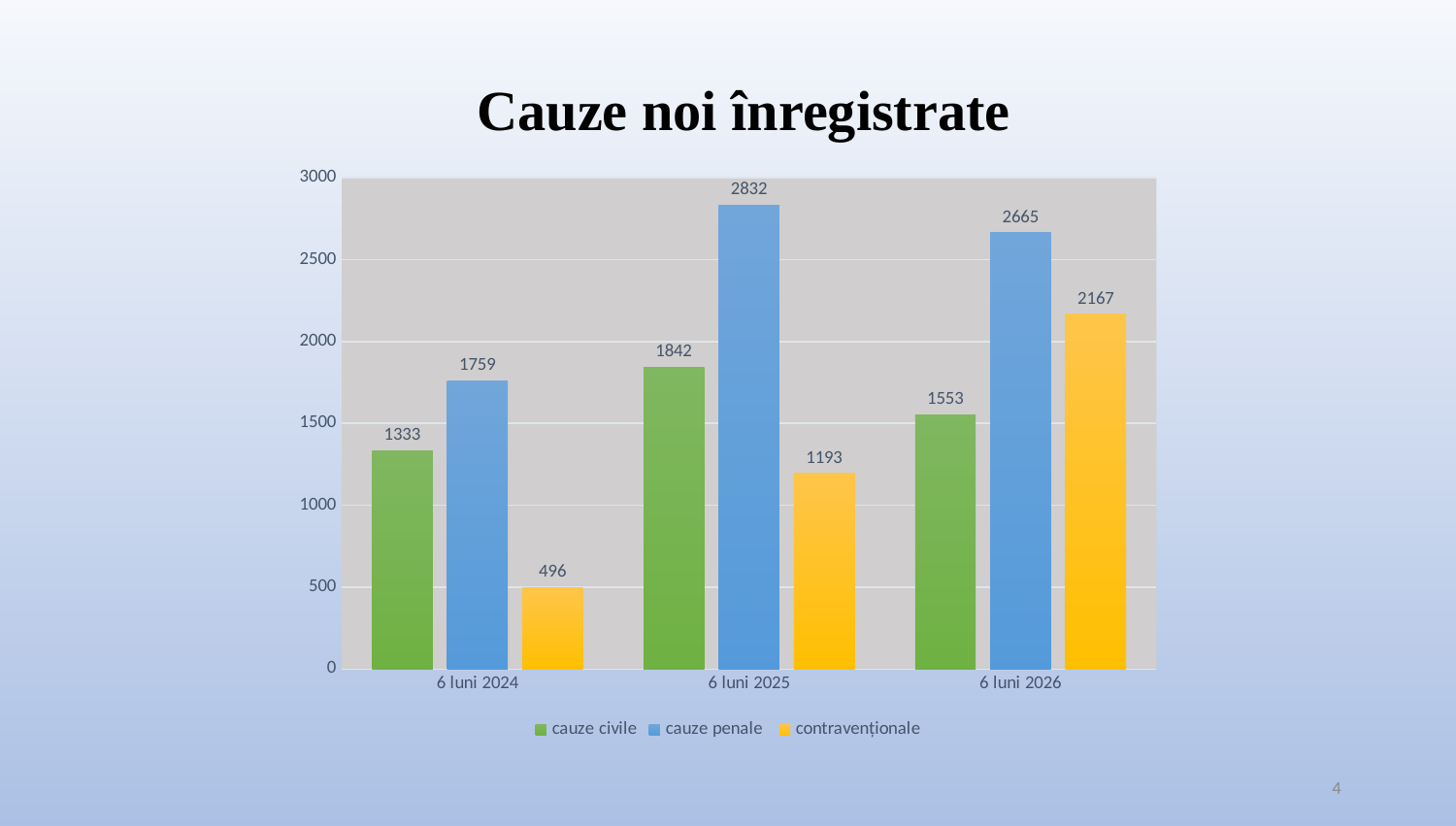
Which period has the highest value for cauze civile? 6 luni 2025 How many series does the legend list? 3 What is the difference between cauze penale in 6 luni 2025 and 6 luni 2026? 167 What is the value for cauze civile in 6 luni 2026? 1553 Which is larger: contravenționale in 6 luni 2026 or cauze civile in 6 luni 2026? contravenționale in 6 luni 2026 What kind of chart is shown on the slide? bar chart What is the value for cauze penale in 6 luni 2025? 2832 How many periods are shown on the x axis? 3 Which period has the lowest value for contravenționale? 6 luni 2024 What is the value for contravenționale in 6 luni 2024? 496 Do the values for contravenționale rise or fall from 6 luni 2024 to 6 luni 2026? rise What is the title of the chart? Cauze noi înregistrate